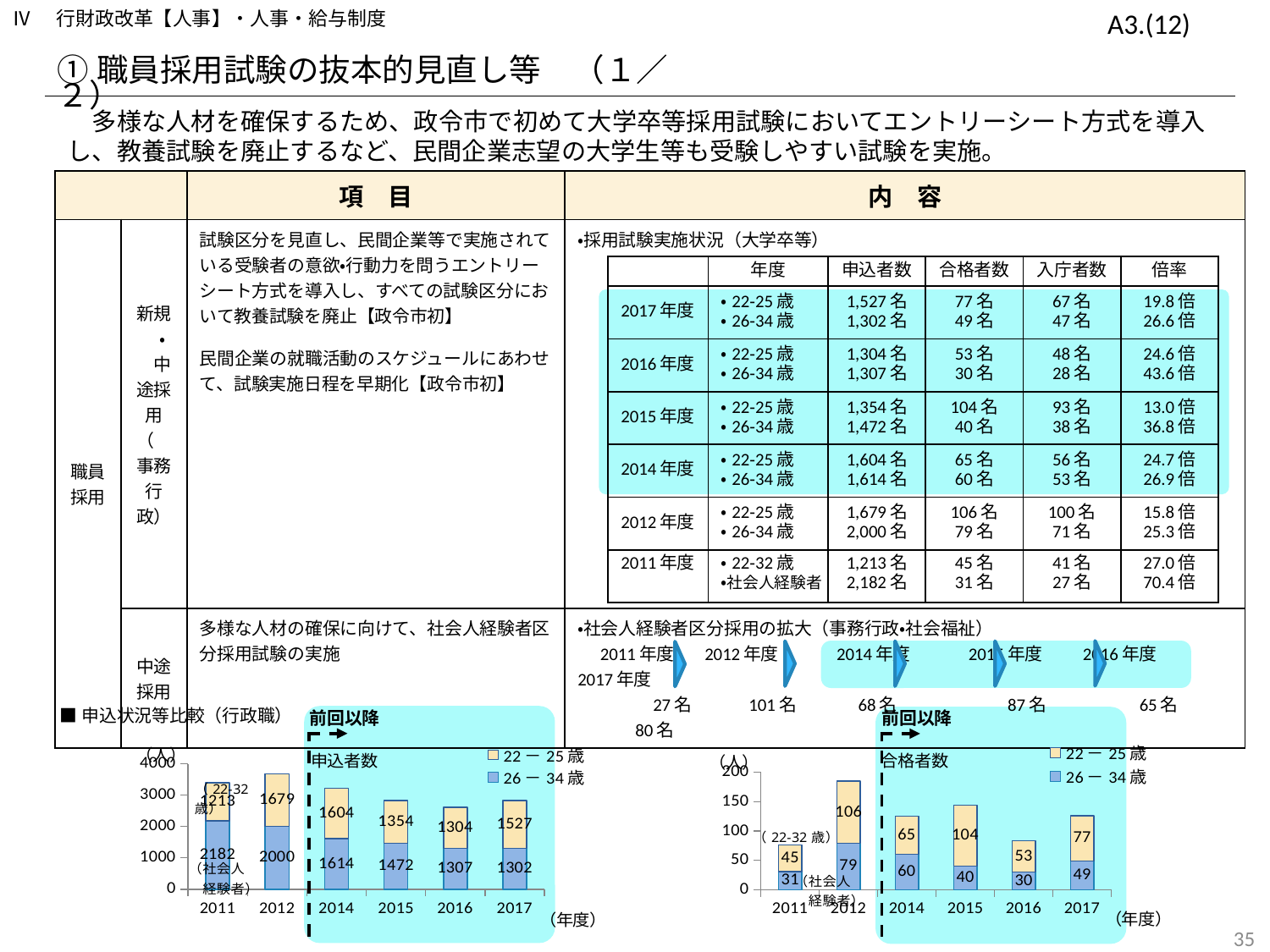
In the left chart (申込者数), what is the difference between the 22－25歳 values for 2014 and 2015? 250 In the right chart (合格者数), which year has the highest total stacked bar? 2012 What kind of chart is the left chart (申込者数)? Stacked bar chart In the left chart (申込者数), what is the total of the stacked bar for 2017? 2829 How many series does the legend of the right chart (合格者数) list? 2 In the left chart (申込者数), what is the value for 22－25歳 in 2014? 1604 In the right chart (合格者数), what is the value for 22－25歳 in 2015? 104 In the right chart (合格者数), which is larger: the 22－25歳 value for 2015 or for 2016? 2015 How many years are shown on the x axis of the left chart (申込者数)? 6 In the right chart (合格者数), what is the total of the stacked bar for 2014? 125 In the right chart (合格者数), what is the value for 26－34歳 in 2017? 49 In the left chart (申込者数), what is the value for 26－34歳 in 2016? 1307